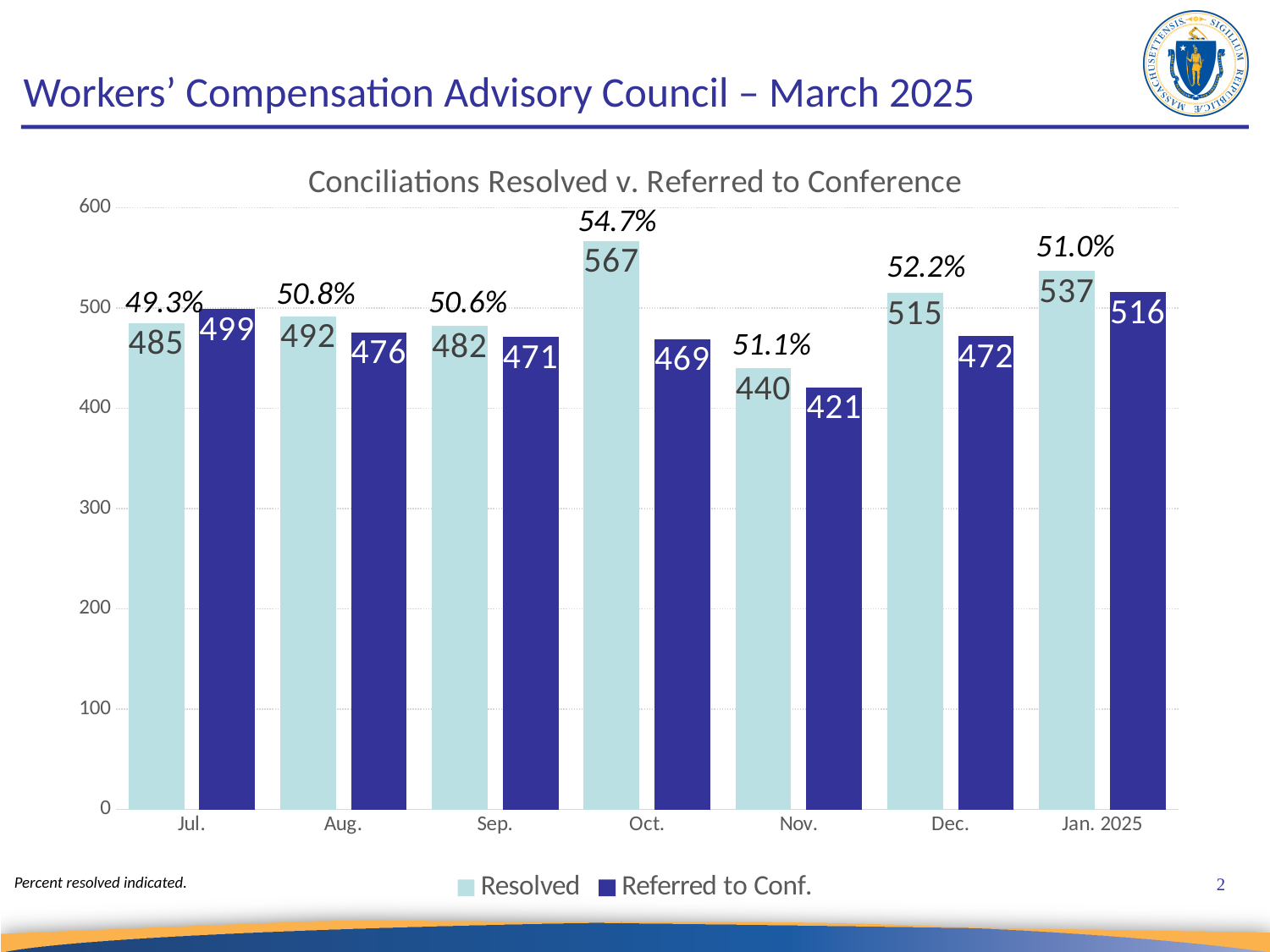
Which is larger for Jul., the Resolved value or the Referred to Conf. value? Referred to Conf. What kind of chart is shown on the slide? Bar chart Which month has the lowest Referred to Conf. value? Nov. How many months are shown on the x axis? 7 What is the difference between the Resolved and Referred to Conf. values for Oct.? 98 What is the Referred to Conf. value for Nov.? 421 Which month has the highest Resolved value? Oct. What percentage is indicated above the Oct. bars? 54.7% What is the Resolved value for Oct.? 567 What is the title of the chart? Conciliations Resolved v. Referred to Conference What is the Resolved value for Jan. 2025? 537 How many series does the legend list? 2